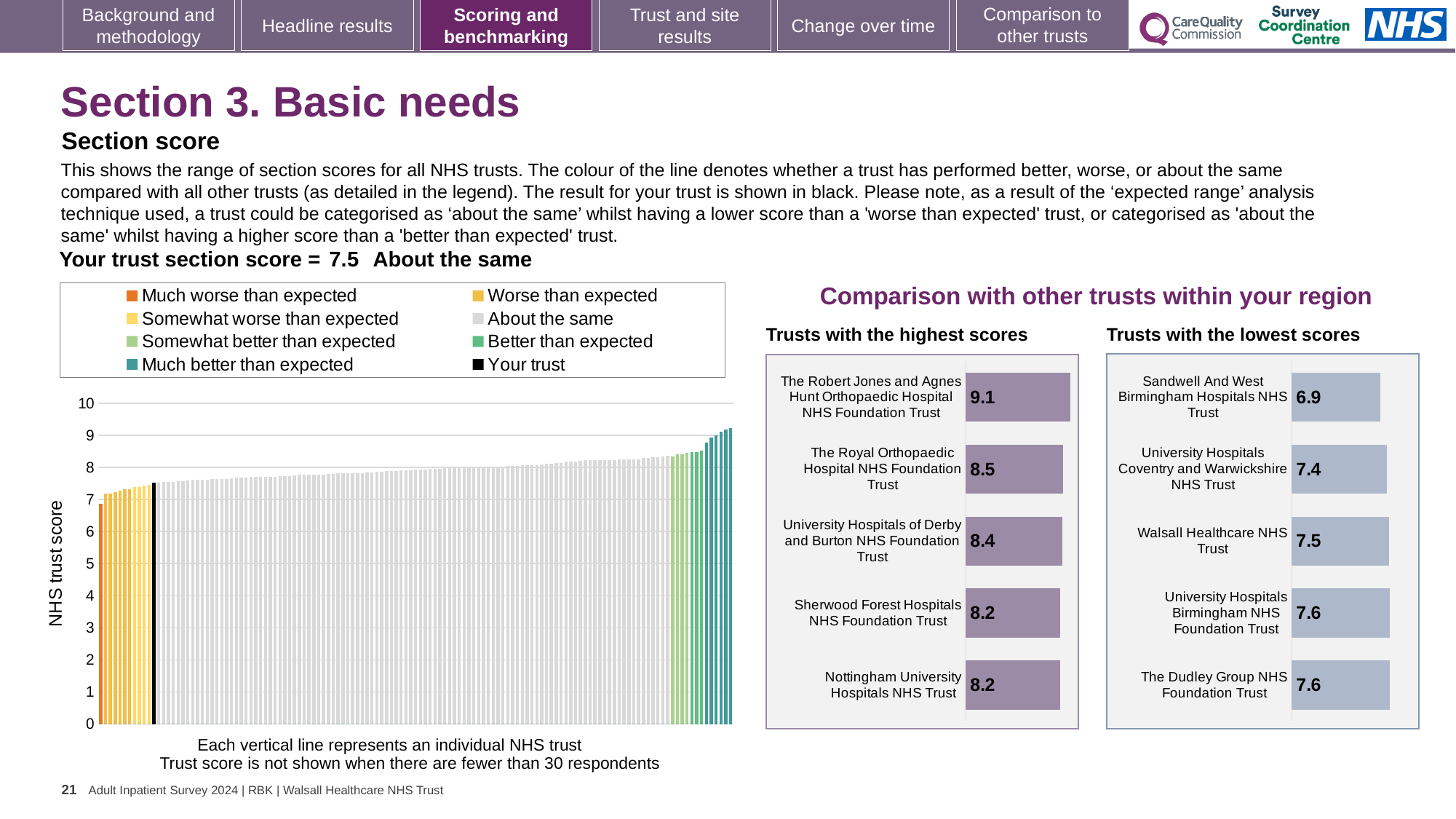
In the 'Trusts with the lowest scores' chart, what is the difference between the scores of Walsall Healthcare NHS Trust and Sandwell And West Birmingham Hospitals NHS Trust? 0.6 In the 'Trusts with the lowest scores' chart, which has the higher score: University Hospitals Coventry and Warwickshire NHS Trust or The Dudley Group NHS Foundation Trust? The Dudley Group NHS Foundation Trust In the large chart on the left, do the trust scores rise or fall from left to right? Rise In the 'Trusts with the highest scores' chart, what is the score for The Robert Jones and Agnes Hunt Orthopaedic Hospital NHS Foundation Trust? 9.1 In the 'Trusts with the highest scores' chart, what is the difference between the scores of The Robert Jones and Agnes Hunt Orthopaedic Hospital NHS Foundation Trust and The Royal Orthopaedic Hospital NHS Foundation Trust? 0.6 What type of chart is the 'Trusts with the lowest scores' chart? Bar chart In the 'Trusts with the lowest scores' chart, what is the score for Sandwell And West Birmingham Hospitals NHS Trust? 6.9 How many entries does the legend of the large chart on the left list? 8 In the large chart on the left, what is the section score for your trust (the black bar)? 7.5 In the 'Trusts with the lowest scores' chart, which trust has the lowest score? Sandwell And West Birmingham Hospitals NHS Trust How many trusts are shown in the 'Trusts with the highest scores' chart? 5 In the 'Trusts with the highest scores' chart, which trust has the highest score? The Robert Jones and Agnes Hunt Orthopaedic Hospital NHS Foundation Trust